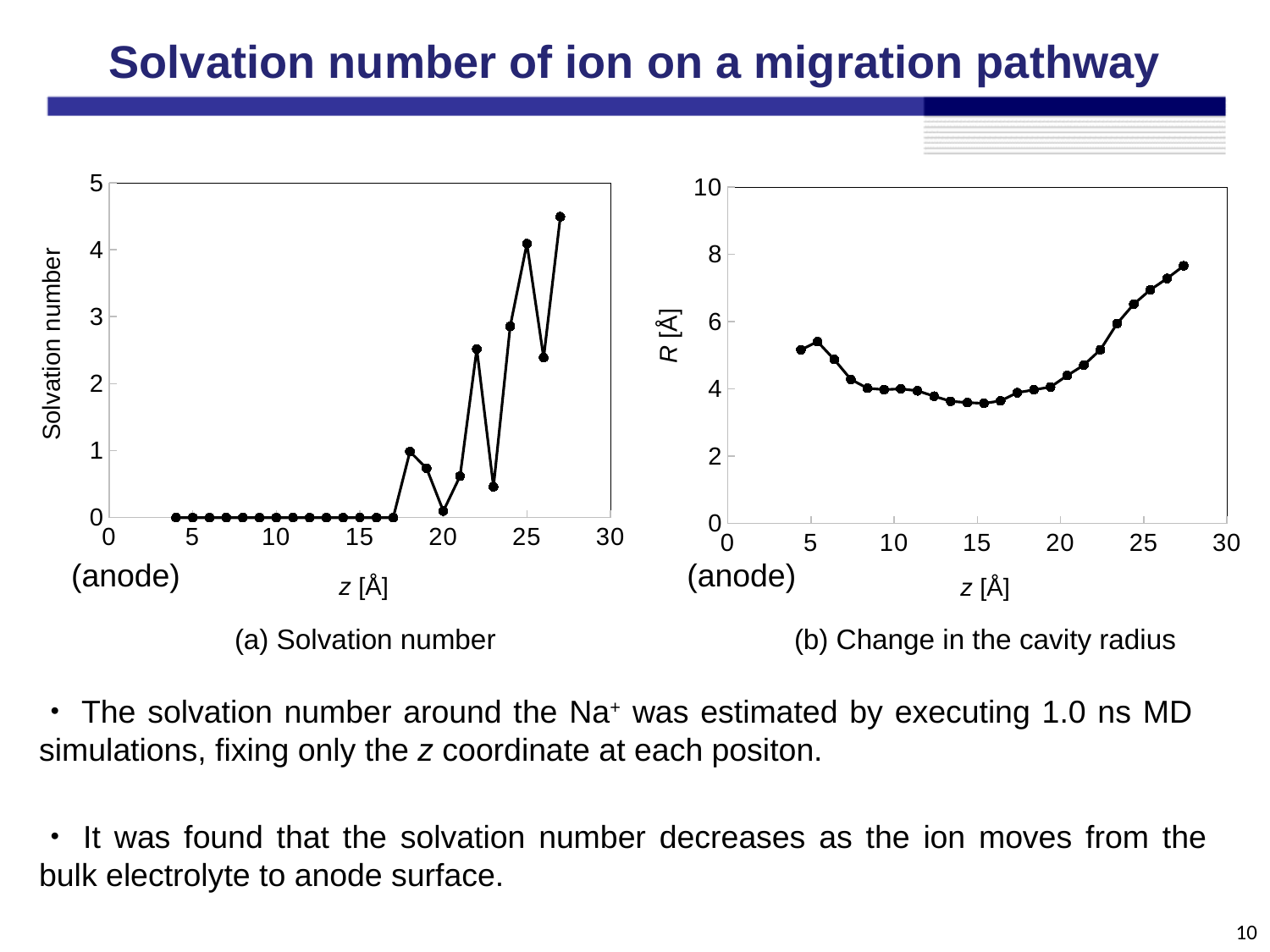
In chart (a) Solvation number, what is the solvation number at z = 10 Å? 0 In chart (a) Solvation number, is the value at z = 27 Å greater or less than 4? greater In chart (a) Solvation number, is the value at z = 20 Å greater or less than 1? less What type of chart is chart (a) Solvation number? line chart In chart (a) Solvation number, at which z value is the solvation number highest? 27 Å In chart (b) Change in the cavity radius, is the value of R at z = 27.5 Å greater or less than 6? greater What is the y-axis label of chart (b)? R [Å] In chart (a) Solvation number, which is larger, the value at z = 25 Å or at z = 26 Å? z = 25 Å What is the x-axis label of chart (a)? z [Å] In chart (b) Change in the cavity radius, is R highest at the left end or the right end of the x axis? right end In chart (b) Change in the cavity radius, does R rise or fall as z increases from 20 Å to 27.5 Å? rise